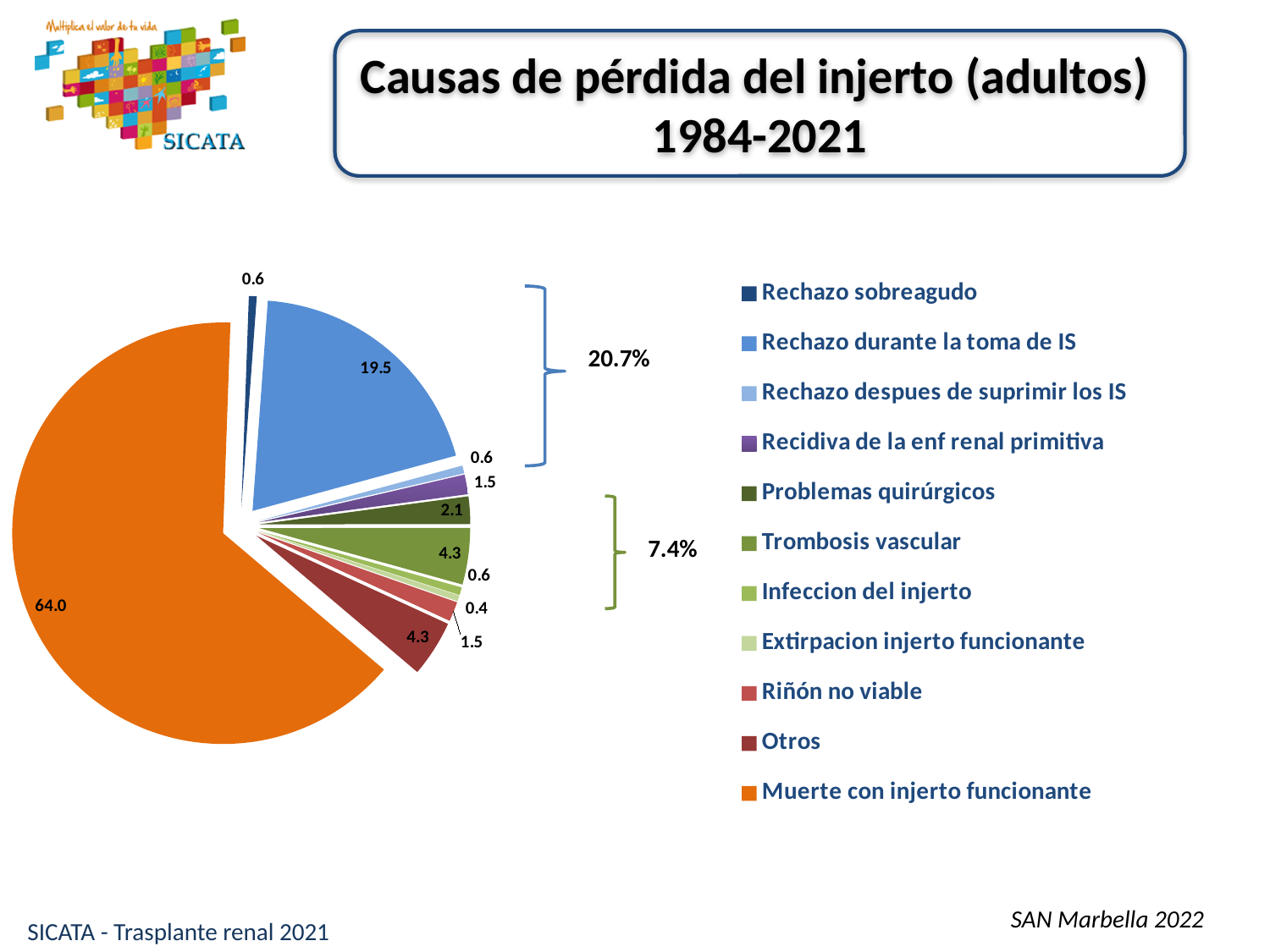
What type of chart is shown on the slide? pie chart What percentage is shown by the bracket grouping the three rejection (Rechazo) slices? 20.7% How many categories does the legend list? 11 Which is larger, the value for Otros or the value for Riñón no viable? Otros What is the value for Trombosis vascular? 4.3 What is the title of the chart? Causas de pérdida del injerto (adultos) 1984-2021 Which category has the smallest slice of the pie? Extirpacion injerto funcionante What is the value for Problemas quirúrgicos? 2.1 What is the difference between the values for Muerte con injerto funcionante and Rechazo durante la toma de IS? 44.5 What is the value for Muerte con injerto funcionante? 64.0 What is the value for Rechazo durante la toma de IS? 19.5 Which category has the largest slice of the pie? Muerte con injerto funcionante